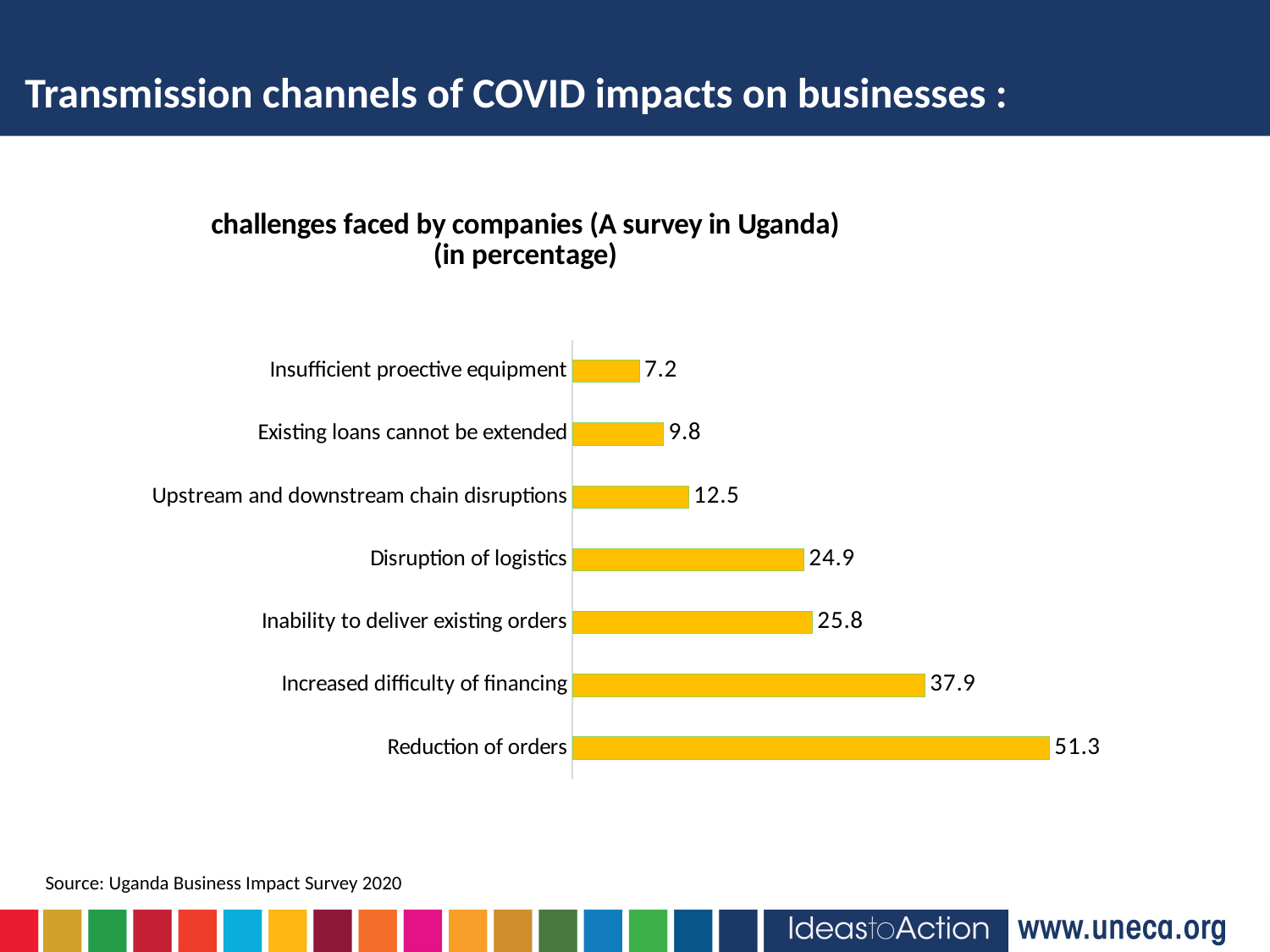
What is the source cited for the chart? Uganda Business Impact Survey 2020 Which challenge has the highest value? Reduction of orders What is the difference between the values for Inability to deliver existing orders and Disruption of logistics? 0.9 What is the value for Reduction of orders? 51.3 How many challenges are shown in the chart? 7 Which is larger: the value for Disruption of logistics or the value for Upstream and downstream chain disruptions? Disruption of logistics What is the value for Upstream and downstream chain disruptions? 12.5 Which challenge has the lowest value? Insufficient proective equipment What is the value for Increased difficulty of financing? 37.9 What is the difference between the values for Reduction of orders and Increased difficulty of financing? 13.4 What is the value for Existing loans cannot be extended? 9.8 What kind of chart is shown on the slide? Bar chart